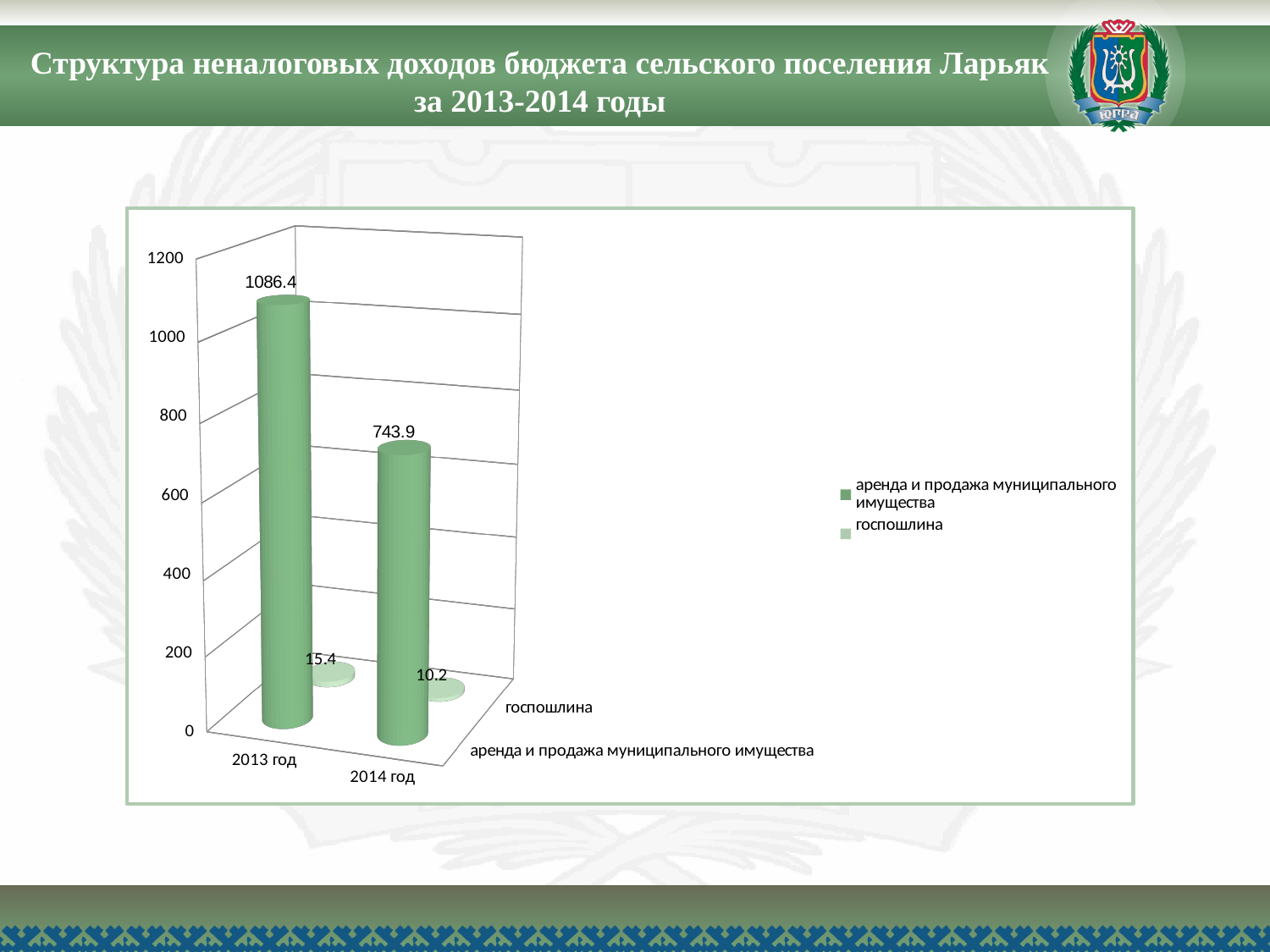
What kind of chart is shown on the slide? bar chart How many series does the legend list? 2 What is the value for госпошлина in 2014 год? 10.2 What is the value for аренда и продажа муниципального имущества in 2013 год? 1086.4 Which year has the lower value for госпошлина? 2014 год By how much did аренда и продажа муниципального имущества decrease from 2013 год to 2014 год? 342.5 Which year has the higher value for аренда и продажа муниципального имущества? 2013 год What is the difference between госпошлина in 2013 год and in 2014 год? 5.2 What is the value for госпошлина in 2013 год? 15.4 Is the value for аренда и продажа муниципального имущества in 2014 год greater or less than 800? less Do the values for аренда и продажа муниципального имущества rise or fall from 2013 год to 2014 год? fall What is the value for аренда и продажа муниципального имущества in 2014 год? 743.9